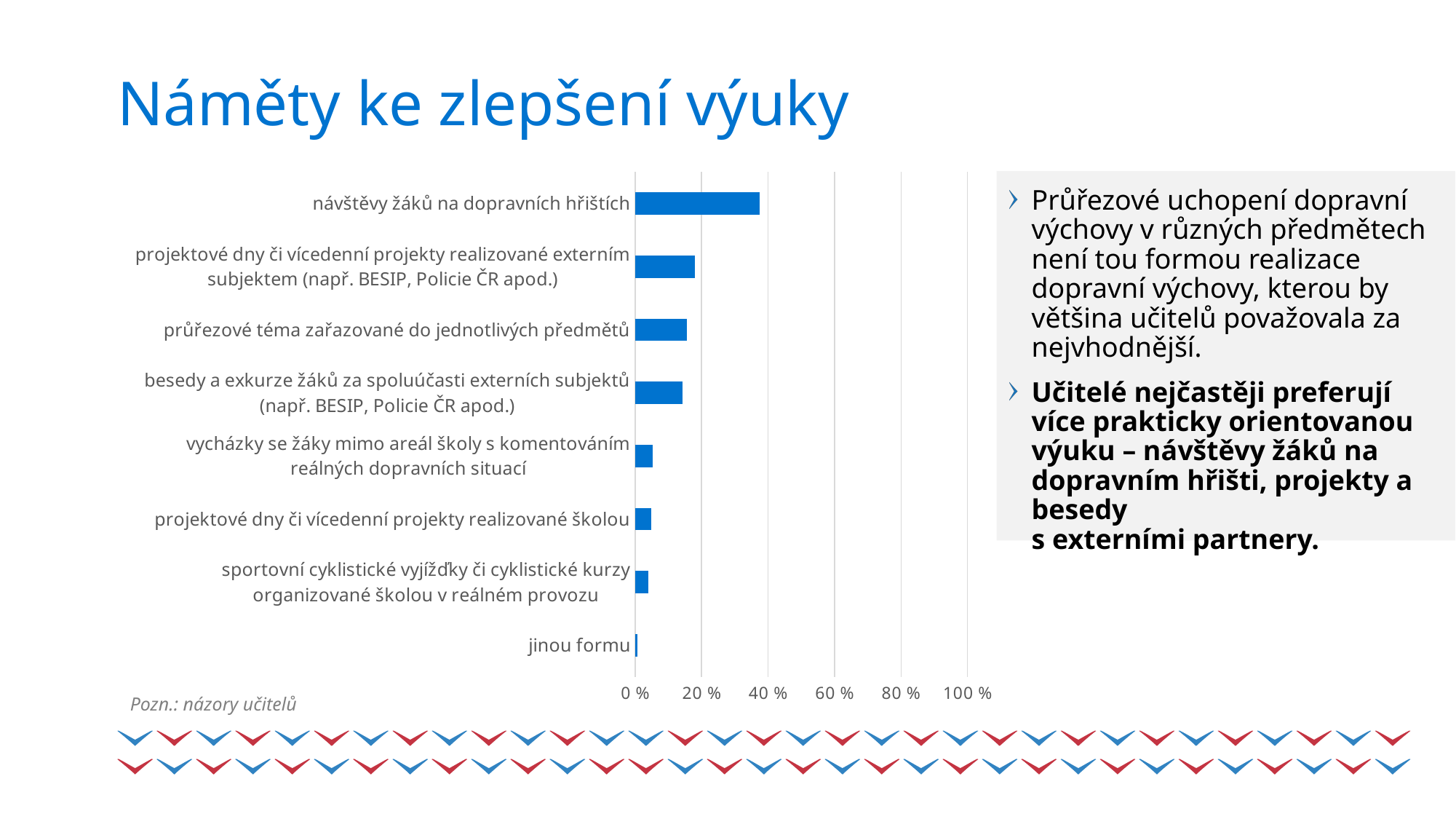
Is the value for 'návštěvy žáků na dopravních hřištích' greater or less than 40 %? less Which category has the lowest value? jinou formu Which has a larger value: 'besedy a exkurze žáků za spoluúčasti externích subjektů (např. BESIP, Policie ČR apod.)' or 'sportovní cyklistické vyjížďky či cyklistické kurzy organizované školou v reálném provozu'? besedy a exkurze žáků za spoluúčasti externích subjektů (např. BESIP, Policie ČR apod.) What is the title of the slide containing the chart? Náměty ke zlepšení výuky What kind of chart is shown on the slide? bar chart Which category has the highest value? návštěvy žáků na dopravních hřištích Is the value for 'průřezové téma zařazované do jednotlivých předmětů' greater or less than 20 %? less How many categories does the chart show? 8 Is the value for 'návštěvy žáků na dopravních hřištích' greater or less than 20 %? greater Which has a larger value: 'návštěvy žáků na dopravních hřištích' or 'průřezové téma zařazované do jednotlivých předmětů'? návštěvy žáků na dopravních hřištích